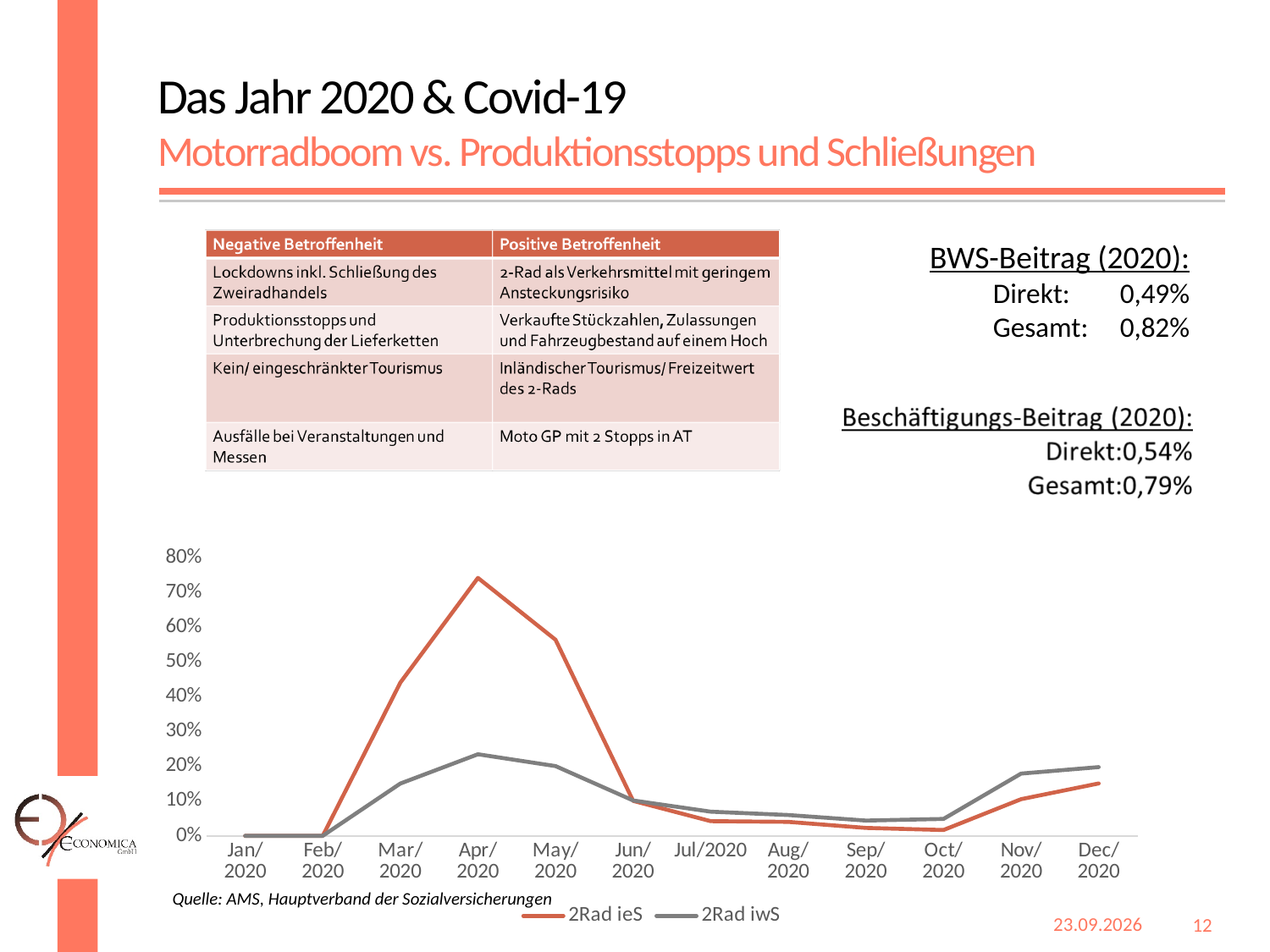
In Nov/2020, which series has the larger value, 2Rad ieS or 2Rad iwS? 2Rad iwS In which month does the 2Rad iwS series reach its highest value? Apr/2020 Is the value for 2Rad ieS in Apr/2020 greater or less than 60%? greater What kind of chart is shown at the bottom of the slide? line chart Does the 2Rad ieS series rise or fall between Apr/2020 and Oct/2020? fall In which month does the 2Rad ieS series reach its highest value? Apr/2020 How many months are plotted along the x axis of the line chart? 12 Is the value for 2Rad ieS in Oct/2020 greater or less than 10%? less What are the names of the two series in the line chart's legend? 2Rad ieS and 2Rad iwS Is the value for 2Rad iwS in Apr/2020 greater or less than 30%? less In Apr/2020, which series has the larger value, 2Rad ieS or 2Rad iwS? 2Rad ieS How many series does the legend of the line chart list? 2